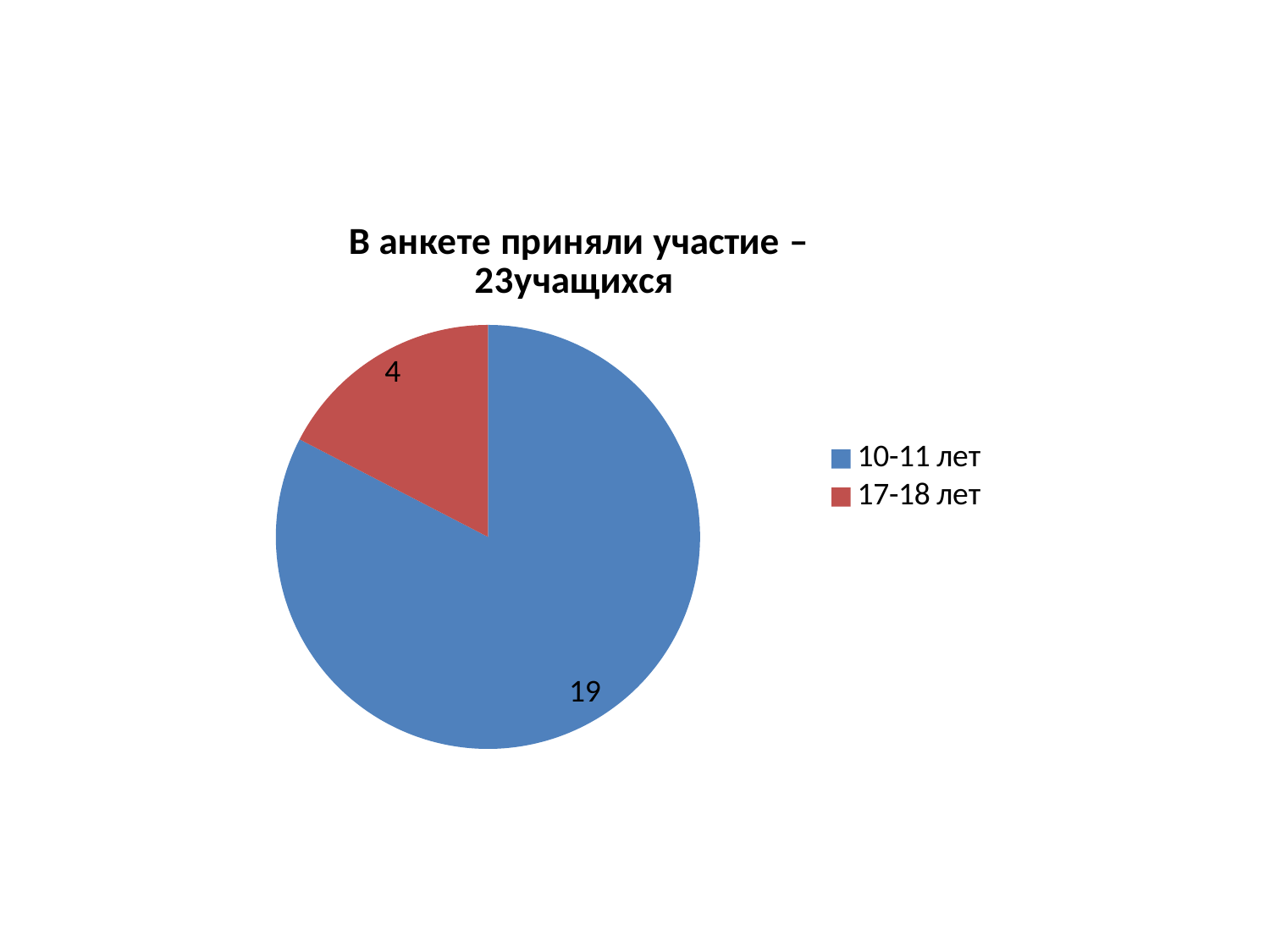
What is the value for the 10-11 лет slice? 19 What is the difference between the values for 10-11 лет and 17-18 лет? 15 What kind of chart is shown on the slide? pie chart What is the value for the 17-18 лет slice? 4 How many slices does the pie chart have? 2 What is the total of all slices in the pie chart? 23 What colour is the slice for 17-18 лет? red Which age group has the largest slice? 10-11 лет How many entries does the legend list? 2 Which age group has the smallest slice? 17-18 лет Which is larger, the value for 10-11 лет or for 17-18 лет? 10-11 лет What is the title of the chart? В анкете приняли участие – 23учащихся